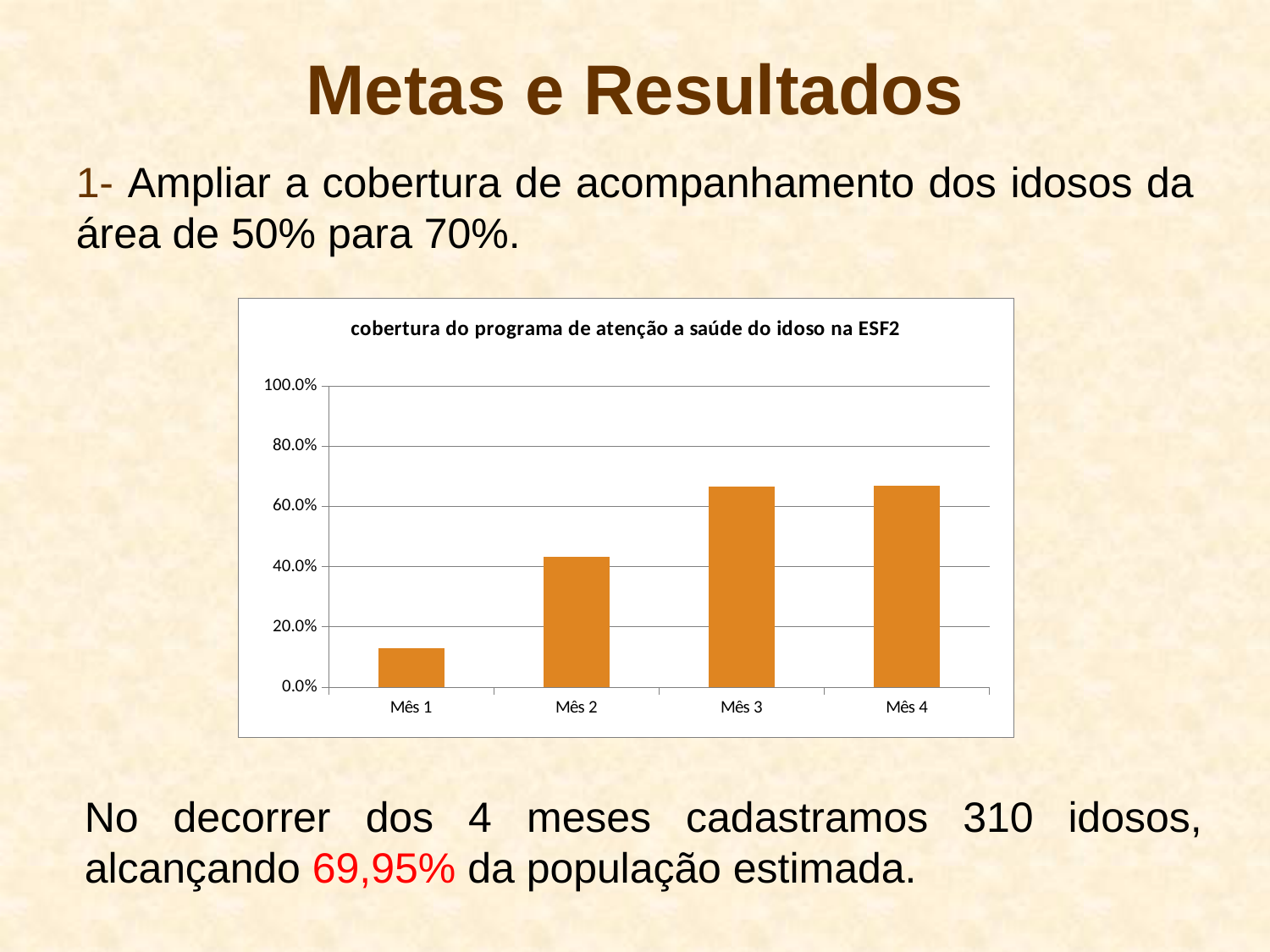
Which month has the lowest coverage value on the chart? Mês 1 What is the title of the chart? cobertura do programa de atenção a saúde do idoso na ESF2 Is the value for Mês 4 greater or less than 80.0%? less What is the highest value shown on the chart's vertical axis? 100.0% What kind of chart is shown on the slide? bar chart Which is larger, the value for Mês 2 or the value for Mês 3? Mês 3 How many categories (months) are plotted on the chart? 4 Do the values generally rise or fall from Mês 1 to Mês 4? rise Is the value for Mês 1 greater or less than 20.0%? less Is the value for Mês 3 greater or less than 60.0%? greater Which is larger, the value for Mês 1 or the value for Mês 2? Mês 2